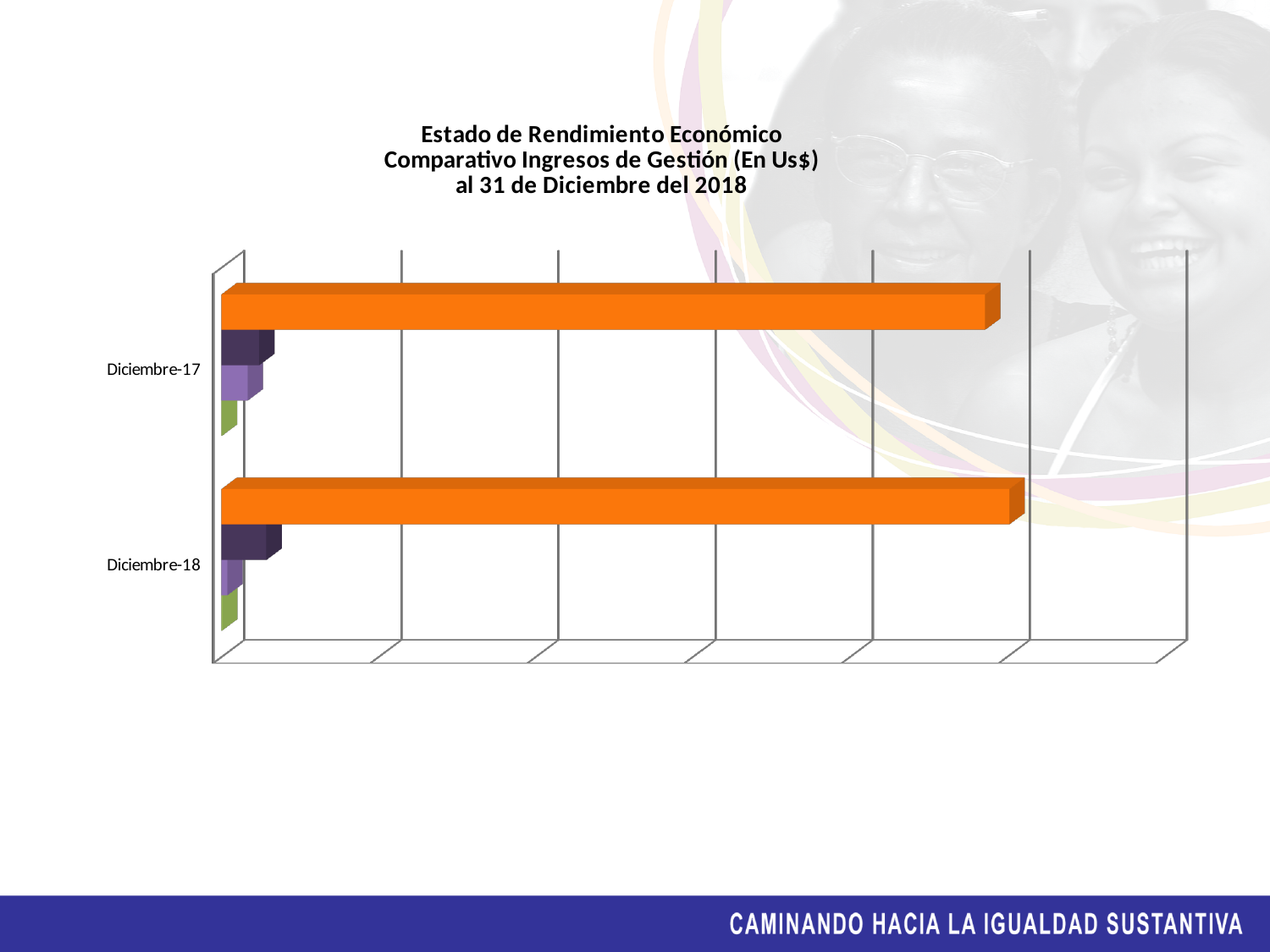
Which category is listed at the top of the chart? Diciembre-17 What kind of chart is shown on the slide? bar chart Which colour bar is the longest for Diciembre-17? orange How many categories are shown on the vertical axis of the chart? 2 What is the first line of the chart's title? Estado de Rendimiento Económico What are the two category labels on the chart's vertical axis? Diciembre-17 and Diciembre-18 Which colour bar is the shortest for Diciembre-18? green Which is larger, the orange bar for Diciembre-17 or the orange bar for Diciembre-18? Diciembre-18 How many bars are drawn for each category in the chart? 4